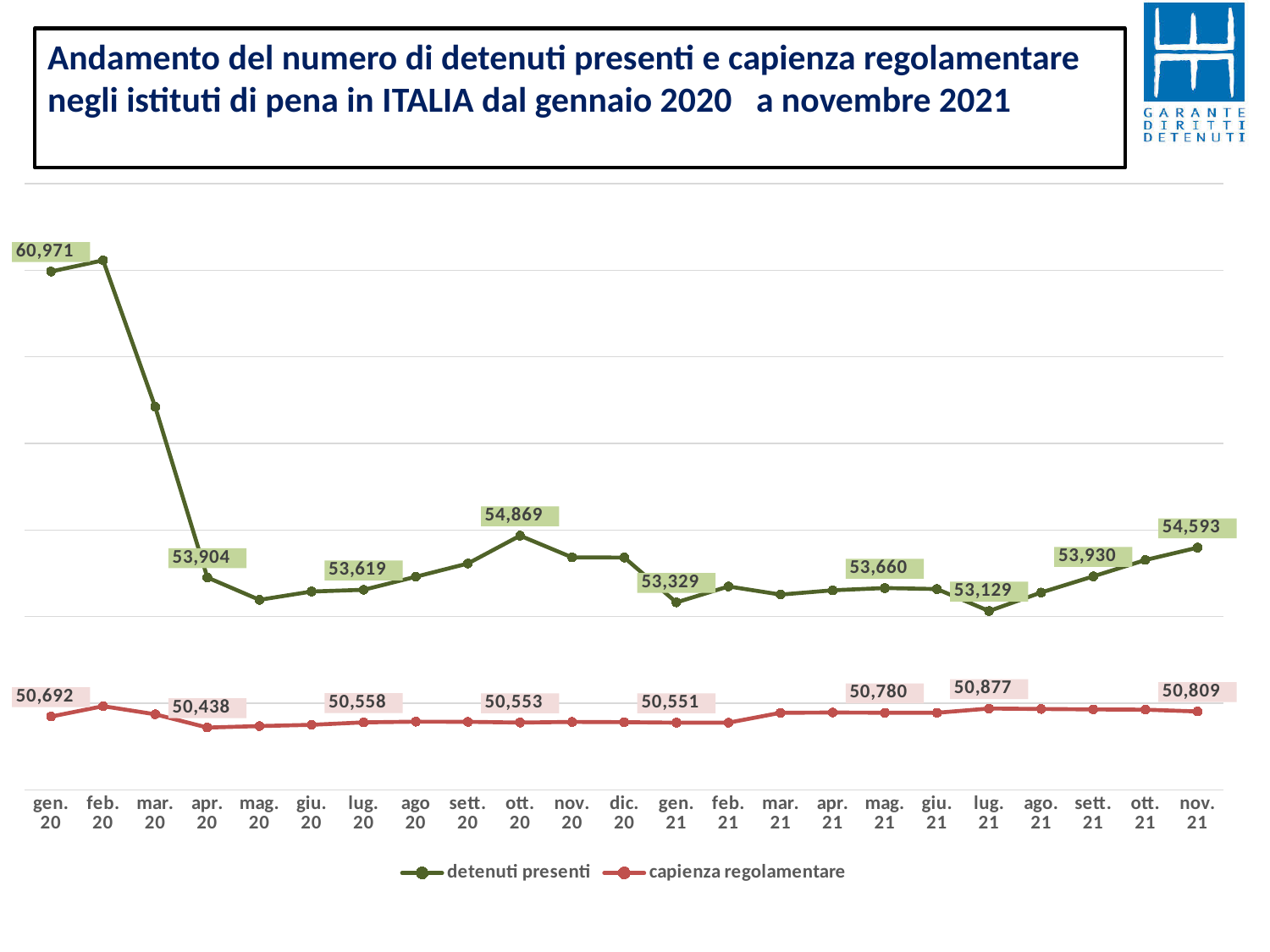
What is the value of 'detenuti presenti' in ott. 20? 54,869 What is the value of 'capienza regolamentare' in nov. 21? 50,809 What is the difference between 'detenuti presenti' and 'capienza regolamentare' in nov. 21? 3,784 What is the value of 'detenuti presenti' in gen. 20? 60,971 How many series does the legend list? 2 Does the 'detenuti presenti' series rise or fall from feb. 20 to apr. 20? fall In which month does the 'detenuti presenti' series reach its lowest value? lug. 21 How many months are plotted on the x axis? 23 What is the value of 'capienza regolamentare' in apr. 20? 50,438 What is the difference between 'detenuti presenti' and 'capienza regolamentare' in gen. 20? 10,279 Which is larger in lug. 21: 'detenuti presenti' or 'capienza regolamentare'? detenuti presenti What kind of chart is shown on the slide? line chart